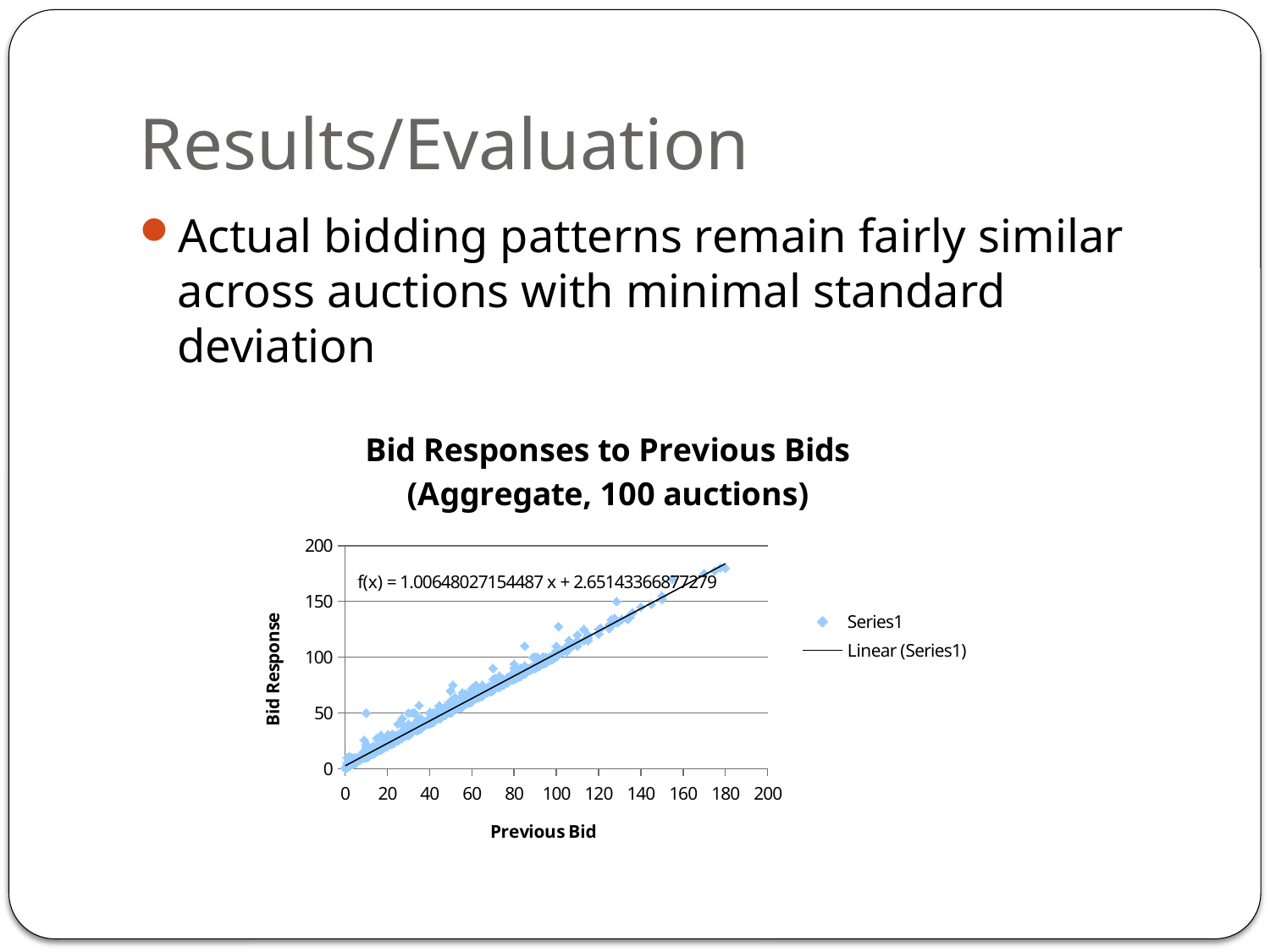
Is the Bid Response for a Previous Bid of 180 greater or less than 150? greater What is the trendline equation printed on the chart? f(x) = 1.00648027154487 x + 2.65143366877279 Do the Bid Response values rise or fall as Previous Bid increases along the x axis? Rise What is the maximum value shown on the y axis of the chart? 200 What kind of chart is shown on the slide? Scatter chart How many entries does the chart's legend list? 2 What is the title of the chart? Bid Responses to Previous Bids (Aggregate, 100 auctions) What are the two entries in the chart's legend? Series1 and Linear (Series1) What is the slope of the linear trendline shown on the chart? 1.00648027154487 What is the intercept of the linear trendline shown on the chart? 2.65143366877279 Is the Bid Response for a Previous Bid of 20 greater or less than 50? less